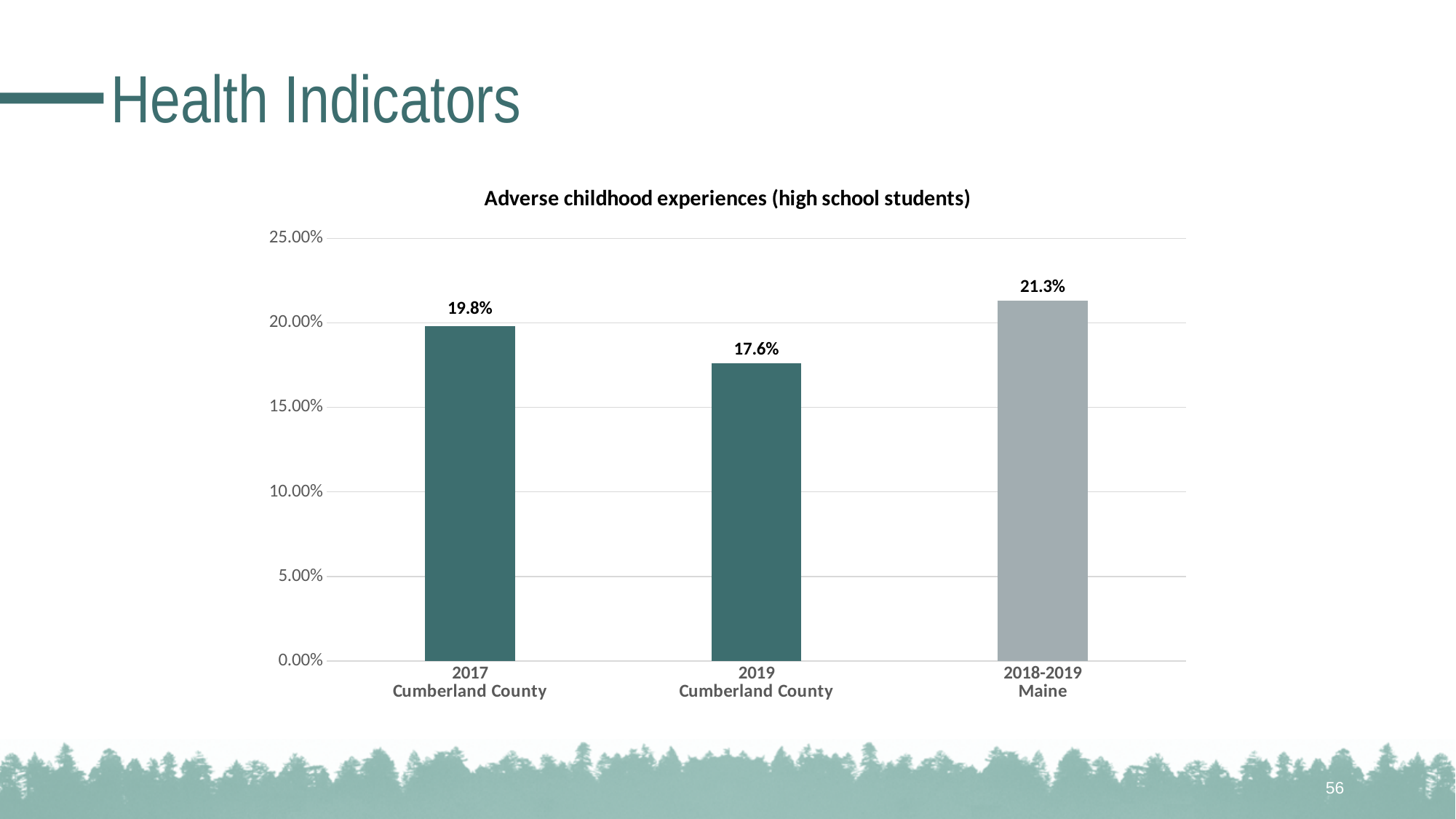
Which category has the highest value? 2018-2019 Maine What is the difference between the 2017 Cumberland County value and the 2019 Cumberland County value? 2.2% What is the value for 2018-2019 Maine? 21.3% Is the value for 2019 Cumberland County greater or less than 20.00%? less Which category has the lowest value? 2019 Cumberland County What kind of chart is shown on the slide? bar chart Which is larger, the value for 2017 Cumberland County or the value for 2018-2019 Maine? 2018-2019 Maine What is the difference between the 2018-2019 Maine value and the 2019 Cumberland County value? 3.7% What is the value for 2019 Cumberland County? 17.6% What is the title of the chart? Adverse childhood experiences (high school students) What is the value for 2017 Cumberland County? 19.8% How many bars are shown in the chart? 3